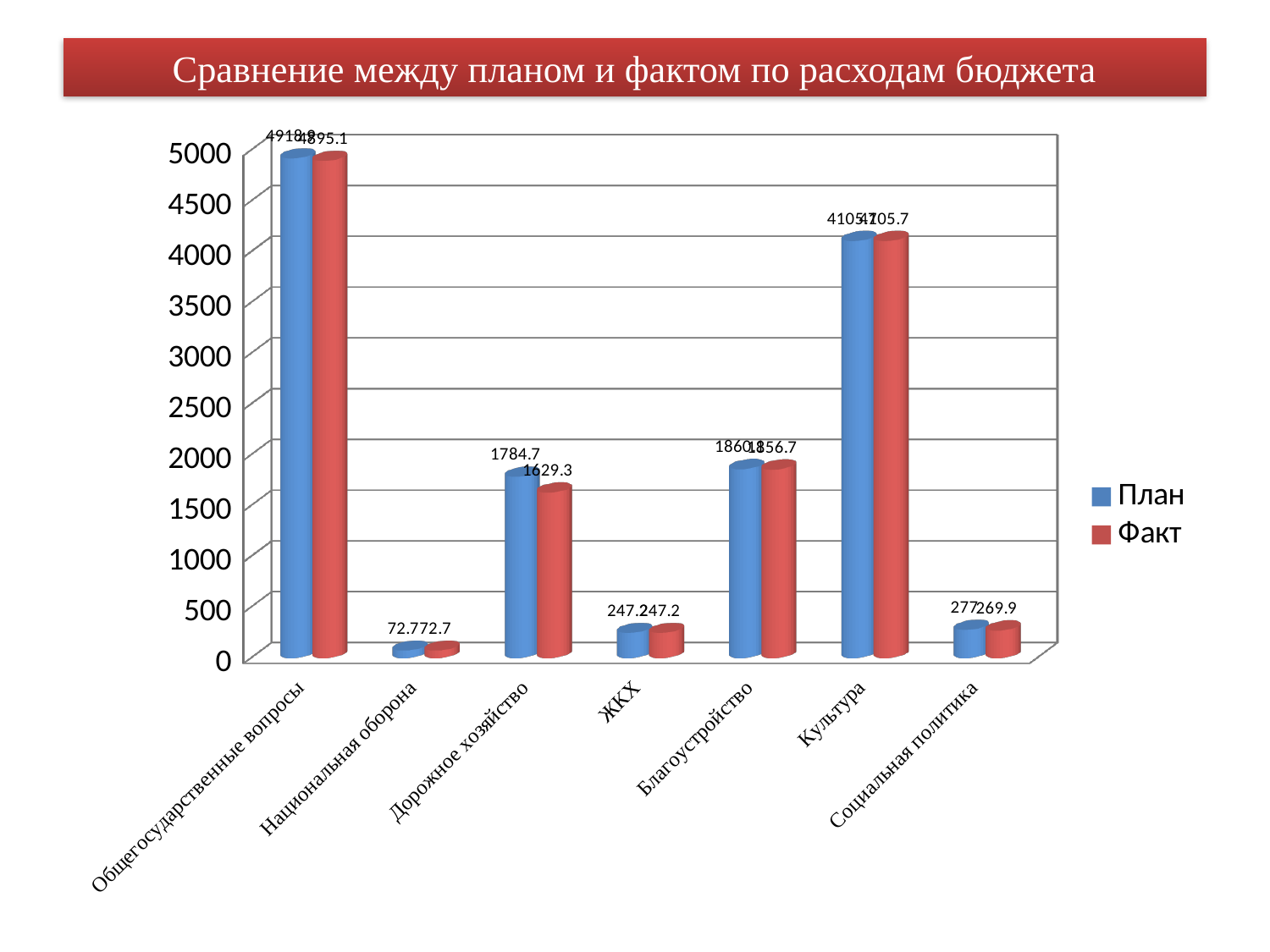
Which category has the highest Факт value? Общегосударственные вопросы What is the Факт value for Социальная политика? 269.9 What kind of chart is shown on the slide? bar chart What is the План value for Дорожное хозяйство? 1784.7 Is the Факт value for Культура greater or less than 4000? greater How many series does the legend list? 2 Which category has the lowest План value? Национальная оборона What is the Факт value for Общегосударственные вопросы? 4895.1 What is the Факт value for Дорожное хозяйство? 1629.3 What is the Факт value for Культура? 4105.7 What is the difference between the План and Факт values for Дорожное хозяйство? 155.4 How many categories are shown on the x axis? 7